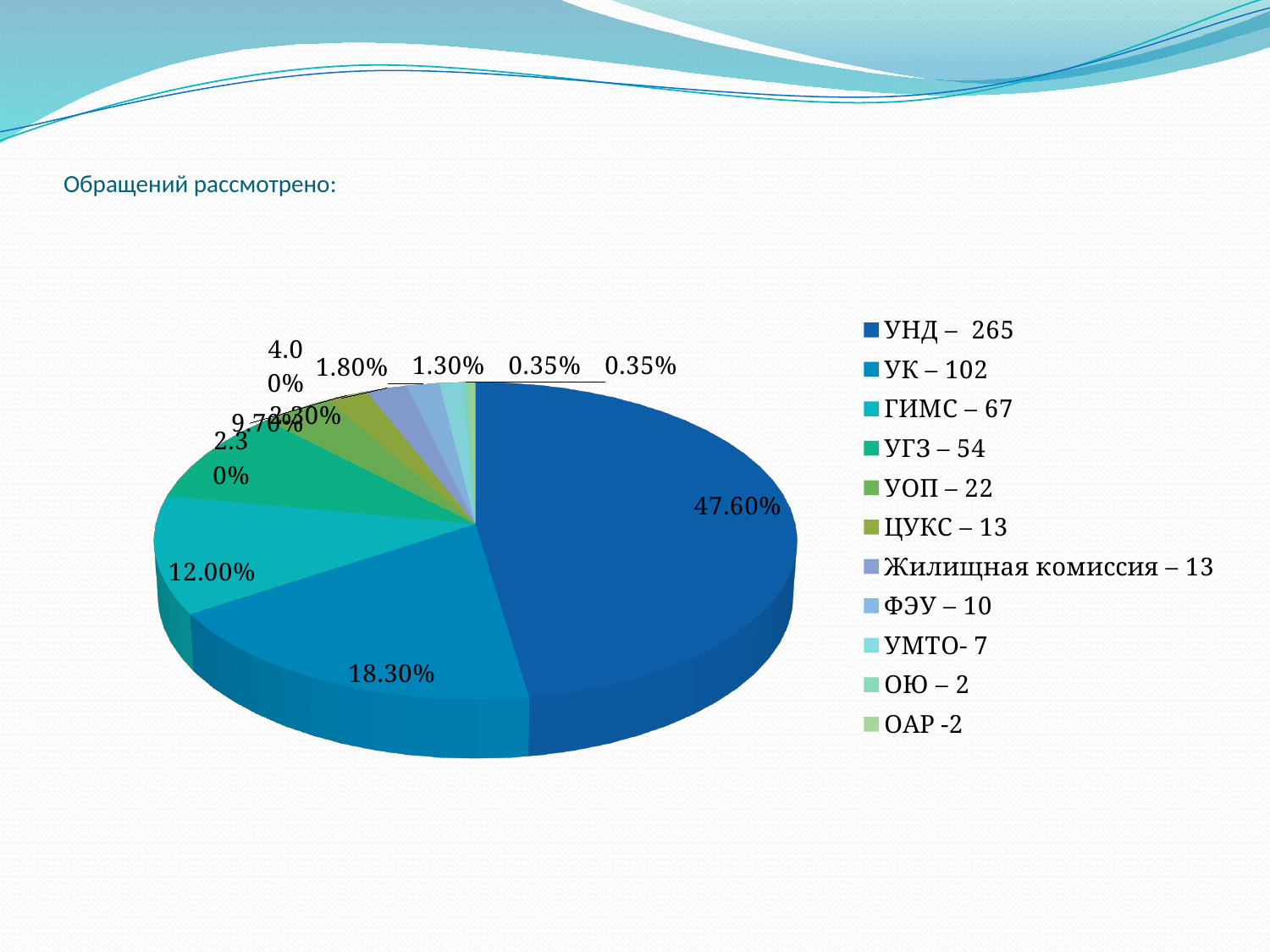
What colour is the УНД slice of the pie? dark blue What is the difference between the counts shown in the legend for УНД (265) and УК (102)? 163 What number is shown next to Жилищная комиссия in the legend? 13 How many categories does the legend of the pie chart list? 11 What kind of chart is shown on the slide? pie chart What share of the pie does ГИМС account for? 12.00% What is the difference in percentage points between the УНД slice (47.60%) and the УК slice (18.30%)? 29.30% What share of the pie does УНД account for? 47.60% What number is shown next to УГЗ in the legend? 54 Which slice is larger, УК or ГИМС? УК Which category has the largest slice of the pie? УНД What share of the pie does УК account for? 18.30%